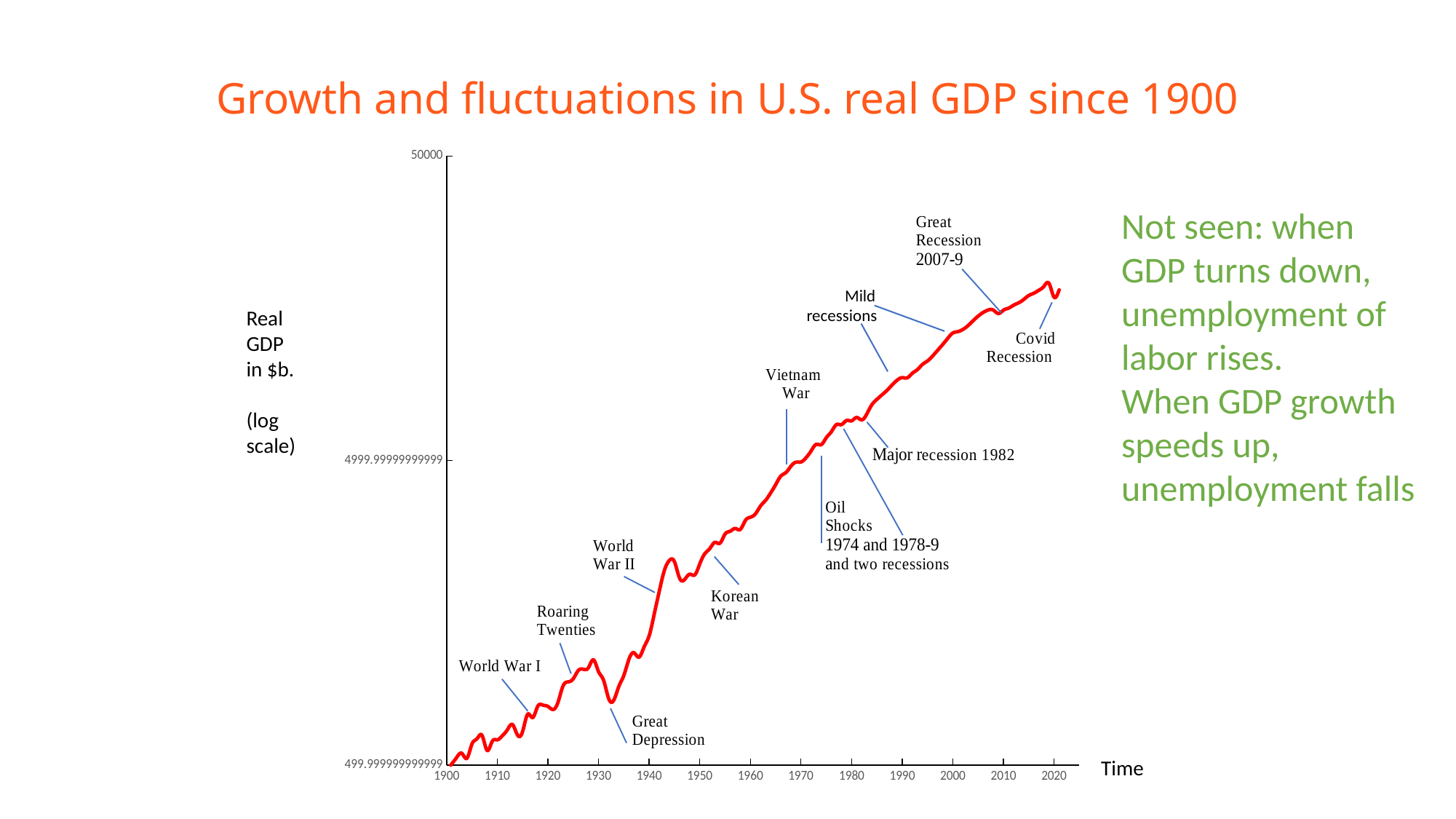
Does real GDP generally rise or fall over time along the x axis? rise Is the value of real GDP in 1990 greater or less than 5000? greater What is the label on the x axis of the chart? Time Is the value of real GDP in 2020 greater or less than 50000? less Which is larger, real GDP in 1940 or real GDP in 1980? 1980 Is the value of real GDP in 2020 greater or less than 5000? greater What is the first year shown on the x axis? 1900 What is the highest value labelled on the y axis? 50000 What kind of chart is shown on the slide? line chart What is the title of the slide's chart? Growth and fluctuations in U.S. real GDP since 1900